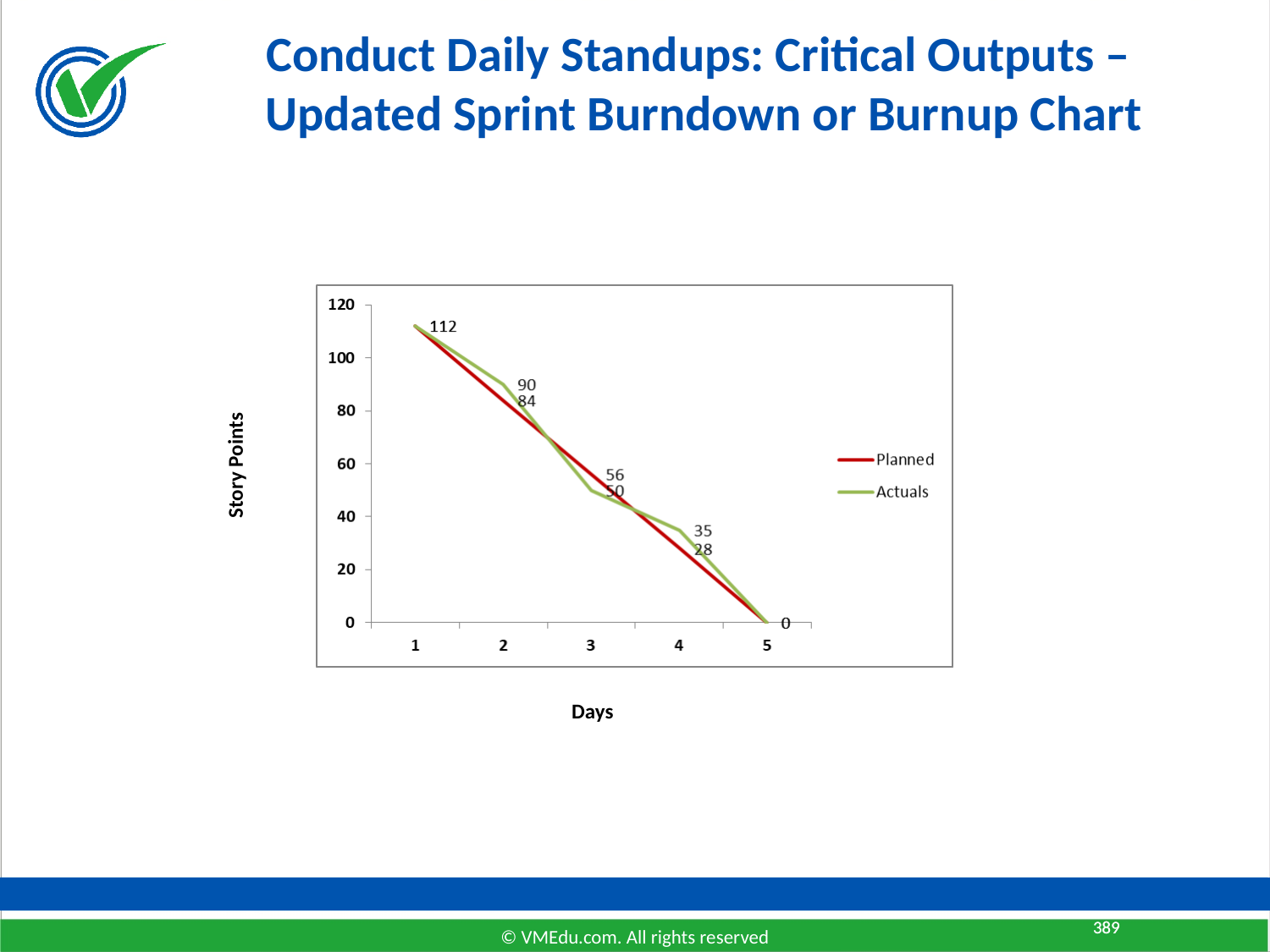
What is the Actuals value on day 4? 35 What is the Planned value on day 3? 56 What is the difference between the Actuals and Planned values on day 2? 6 What is the label of the y axis? Story Points What is the story points value on day 1? 112 On day 3, which series has the higher value, Planned or Actuals? Planned Do the story points rise or fall from day 1 to day 5? fall What kind of chart is shown on the slide? line chart How many series does the legend list? 2 How many days are plotted along the x axis? 5 What is the Actuals value on day 2? 90 What is the story points value on day 5? 0